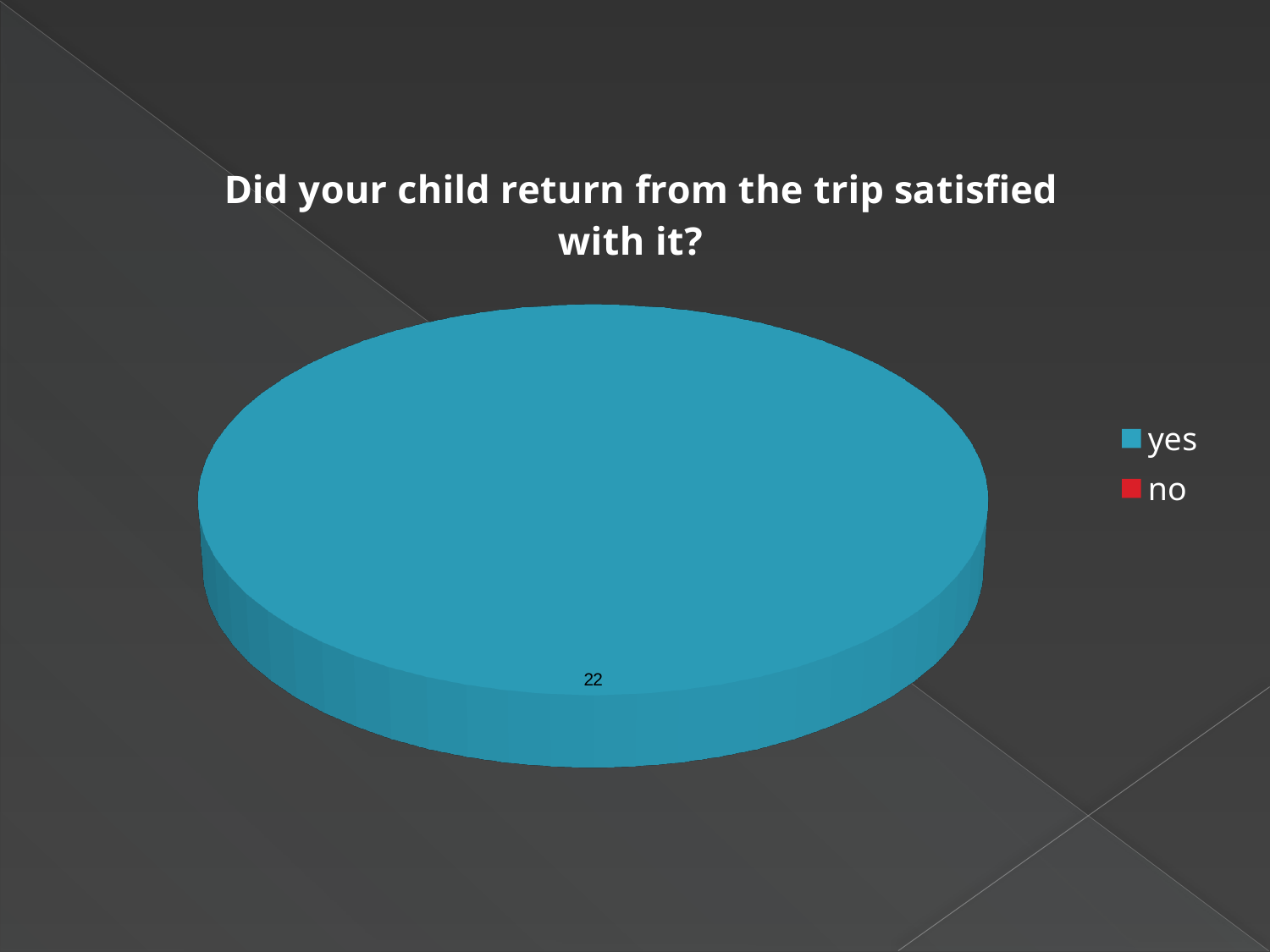
What kind of chart is shown on the slide? pie chart What value is shown for the "yes" slice? 22 Is the value for "yes" greater or less than 20? greater What share of the pie does the "yes" slice take up? 100% How many entries does the legend list? 2 Which category has the largest slice of the pie? yes What colour represents "yes" in the legend? blue Which is larger, the "yes" slice or the "no" slice? yes What is the title of the chart? Did your child return from the trip satisfied with it?